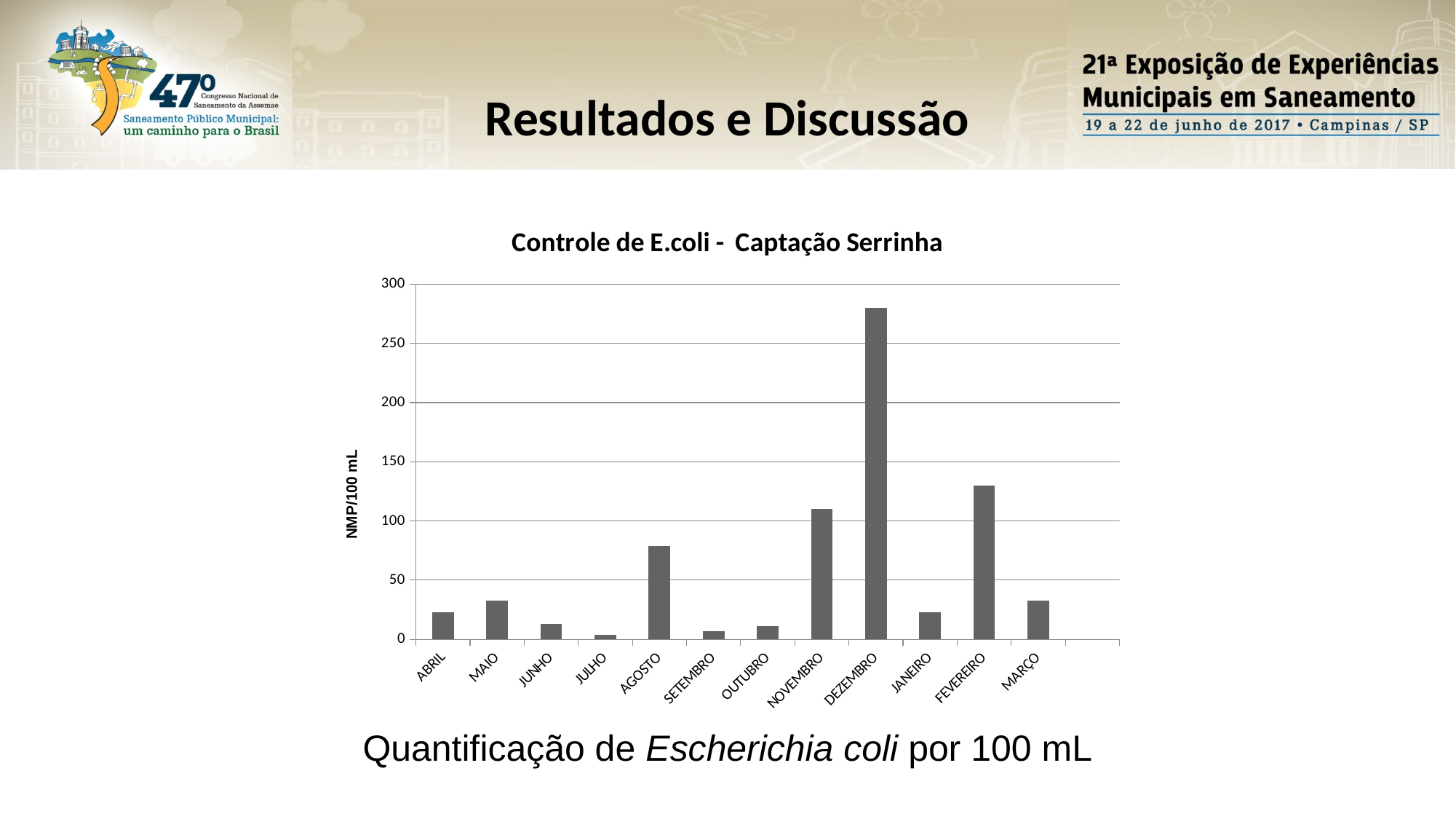
Is the value for AGOSTO greater or less than 100? less What is the label of the vertical axis? NMP/100 mL What kind of chart is shown on the slide? Bar chart Which month has the lowest value? JULHO What is the title of the chart? Controle de E.coli - Captação Serrinha Is the value for NOVEMBRO greater or less than 150? less Which is larger, the value for AGOSTO or the value for NOVEMBRO? NOVEMBRO How many months are shown on the x axis of the chart? 12 Which month has the highest value? DEZEMBRO Which is larger, the value for DEZEMBRO or the value for FEVEREIRO? DEZEMBRO Is the value for FEVEREIRO greater or less than 100? greater